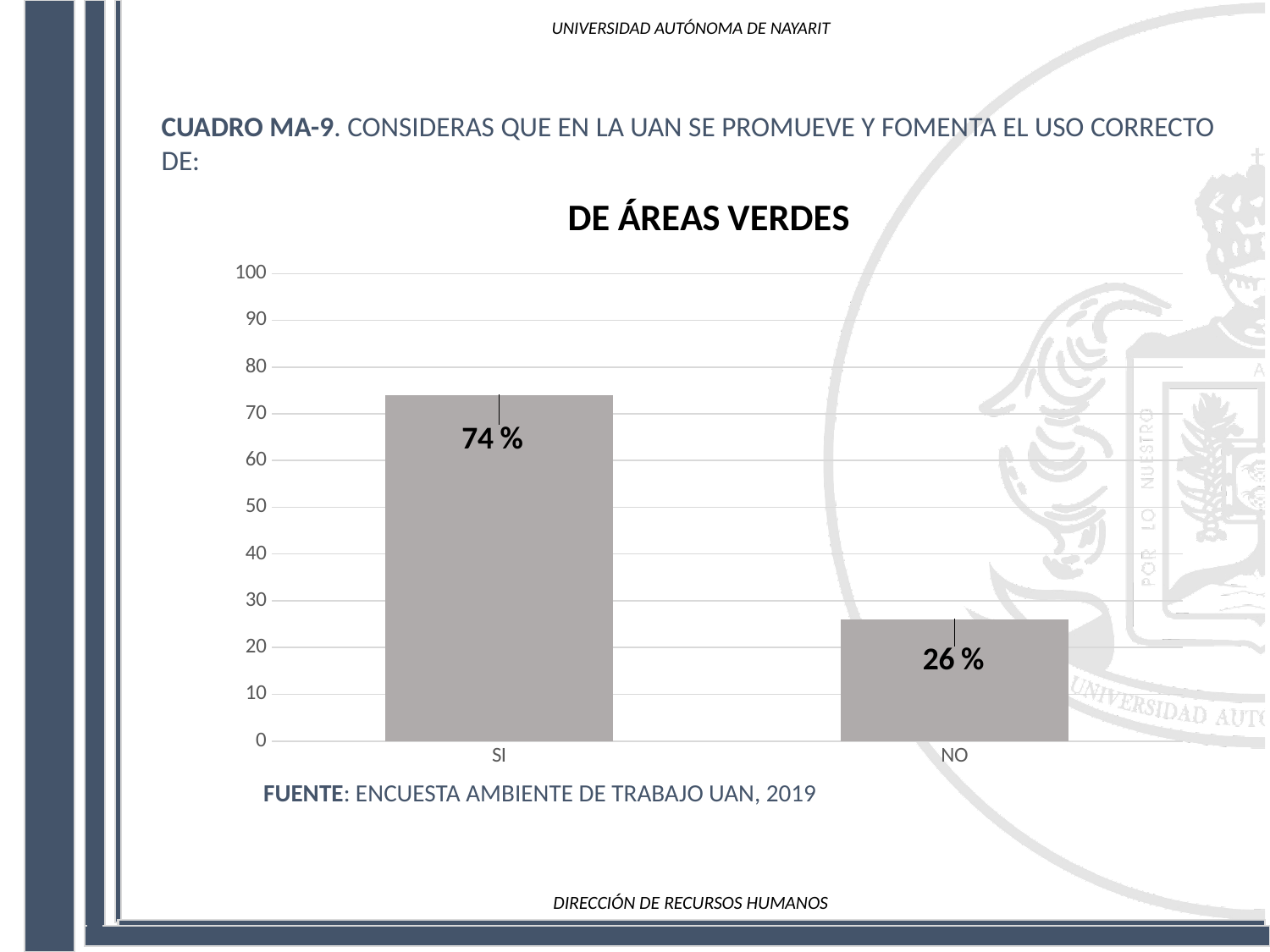
What is the highest value shown on the y axis? 100 Which category has the highest value? SI Which is larger, the value for SI or the value for NO? SI What is the title of the chart? DE ÁREAS VERDES How many categories are shown on the x axis? 2 What is the value for SI? 74 % Is the value for NO greater or less than 30? less What is the value for NO? 26 % Which category has the lowest value? NO What is the difference between the values for SI and NO? 48 % Is the value for SI greater or less than 70? greater What kind of chart is shown on the slide? bar chart